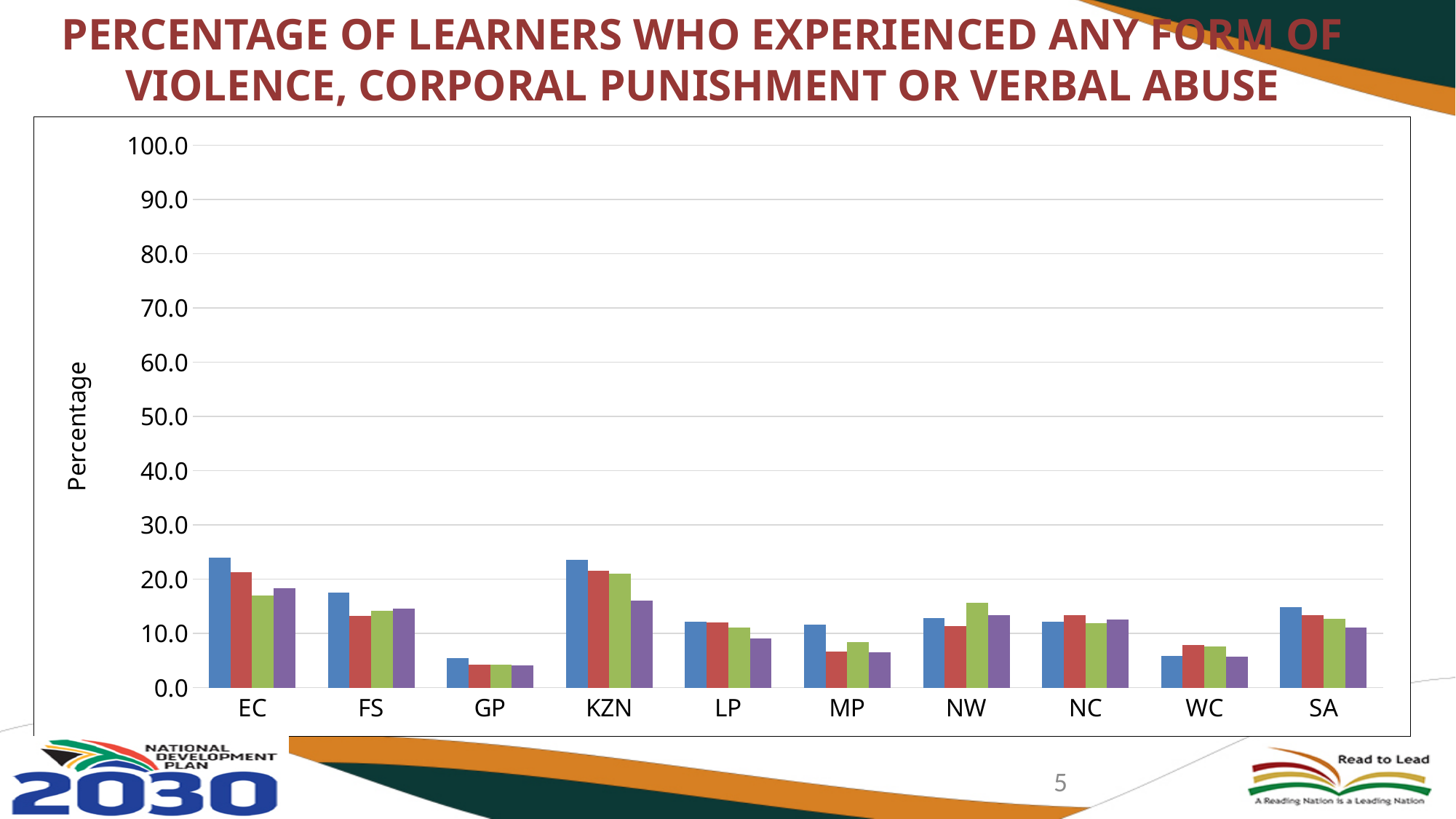
What kind of chart is shown on the slide? bar chart For NW, which is larger, the green bar or the blue bar? the green bar Which is larger, the blue bar for EC or the blue bar for FS? EC Is the value of the blue bar for EC greater or less than 20? greater Is the value of the green bar for NW greater or less than 10? greater What is the label on the vertical axis of the chart? Percentage Is the value of the blue bar for WC greater or less than 10? less How many provinces/categories are shown along the x axis of the chart? 10 Which category has the lowest bars overall on the chart? GP How many bars are plotted for each category on the chart? 4